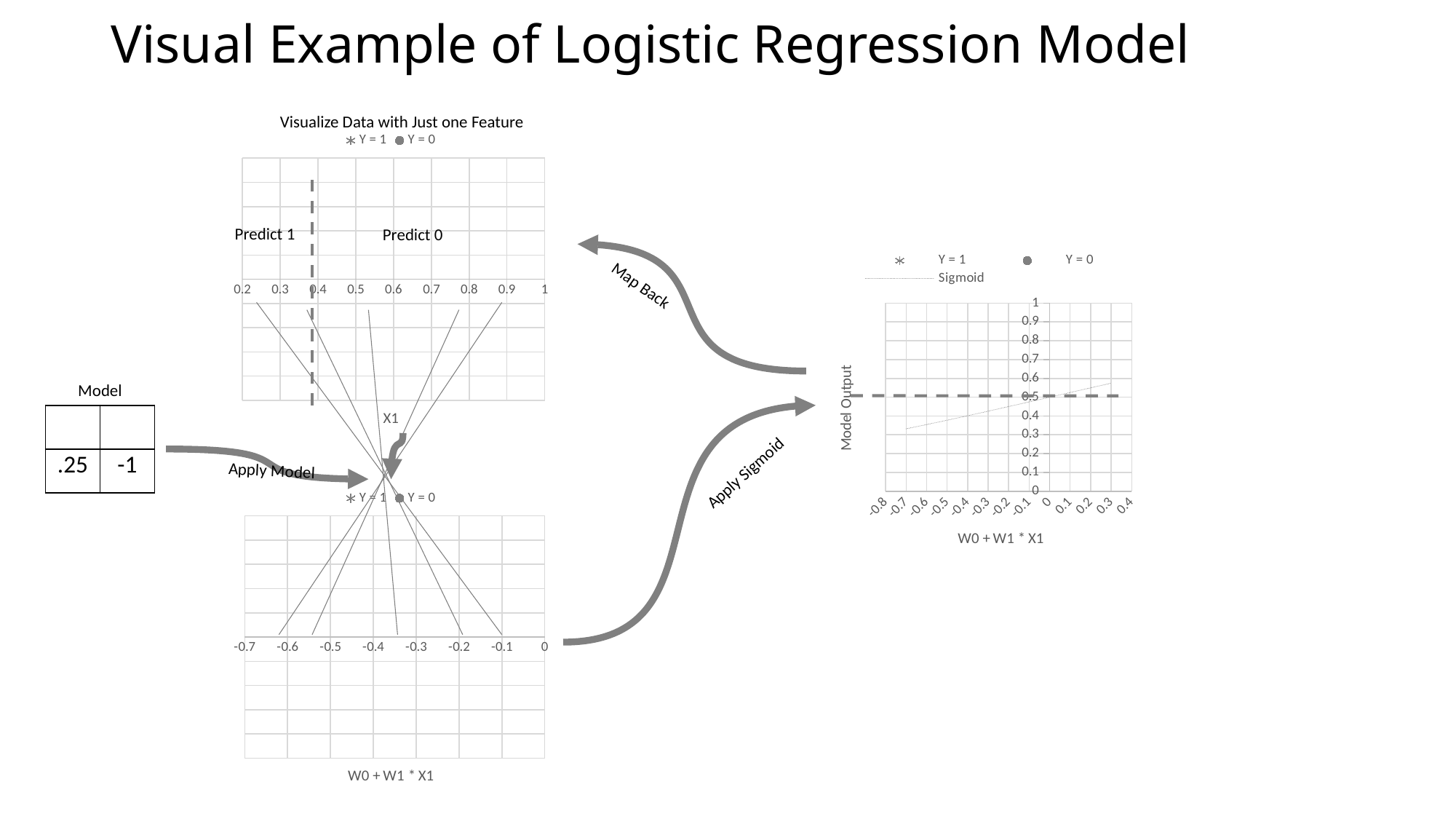
In the right-hand chart, is the Sigmoid value at W0 + W1 * X1 = 0.3 greater or less than 0.5? greater What kind of chart is the right-hand chart with the Model Output axis? scatter chart In the right-hand chart (Model Output), how many series does the legend list? 3 What is the vertical axis title of the right-hand chart? Model Output In the top-left chart titled 'Visualize Data with Just one Feature', how many series does the legend list? 2 In the right-hand chart, is the Sigmoid value at W0 + W1 * X1 = -0.7 greater or less than 0.5? less In the right-hand chart, does the Sigmoid line rise or fall as W0 + W1 * X1 increases? rises What is the title of the top-left chart? Visualize Data with Just one Feature